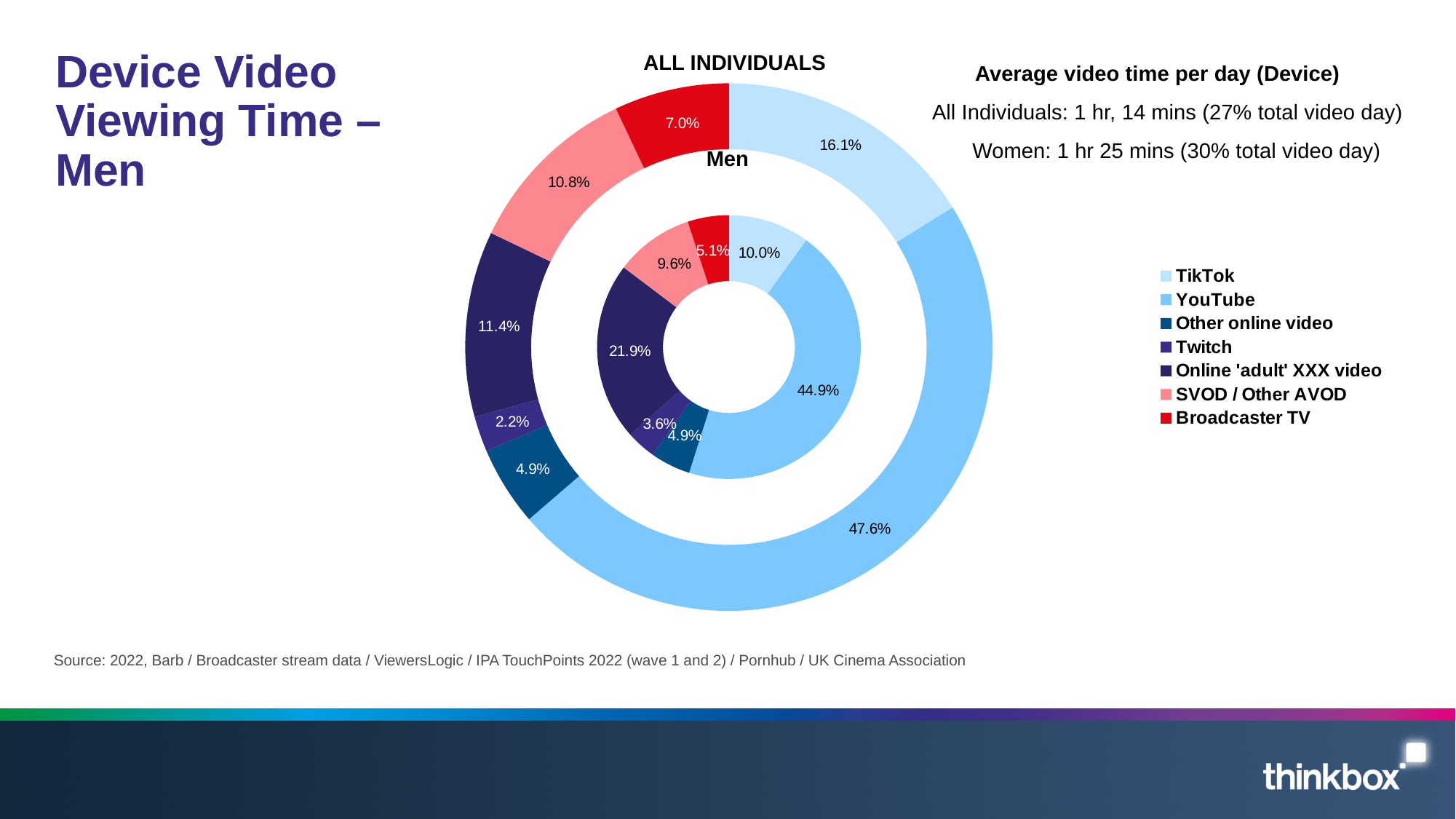
In the outer ring (All Individuals), what share is Broadcaster TV? 7.0% In the outer ring (All Individuals), what share of device video viewing time is YouTube? 47.6% How many entries does the chart legend list? 7 Which category has the largest share in the Men ring? YouTube What is the difference between the Online 'adult' XXX video share for Men (21.9%) and for All Individuals (11.4%)? 10.5 percentage points In the inner ring (Men), what share of device video viewing time is Online 'adult' XXX video? 21.9% Which ring of the doughnut chart represents Men, the inner or the outer? Inner Which is larger: the TikTok share for All Individuals or the TikTok share for Men? All Individuals Which category has the smallest share in the All Individuals ring? Twitch What is the difference between the YouTube share for All Individuals (47.6%) and for Men (44.9%)? 2.7 percentage points What kind of chart is shown on the slide? Doughnut chart In the inner ring (Men), what share is TikTok? 10.0%